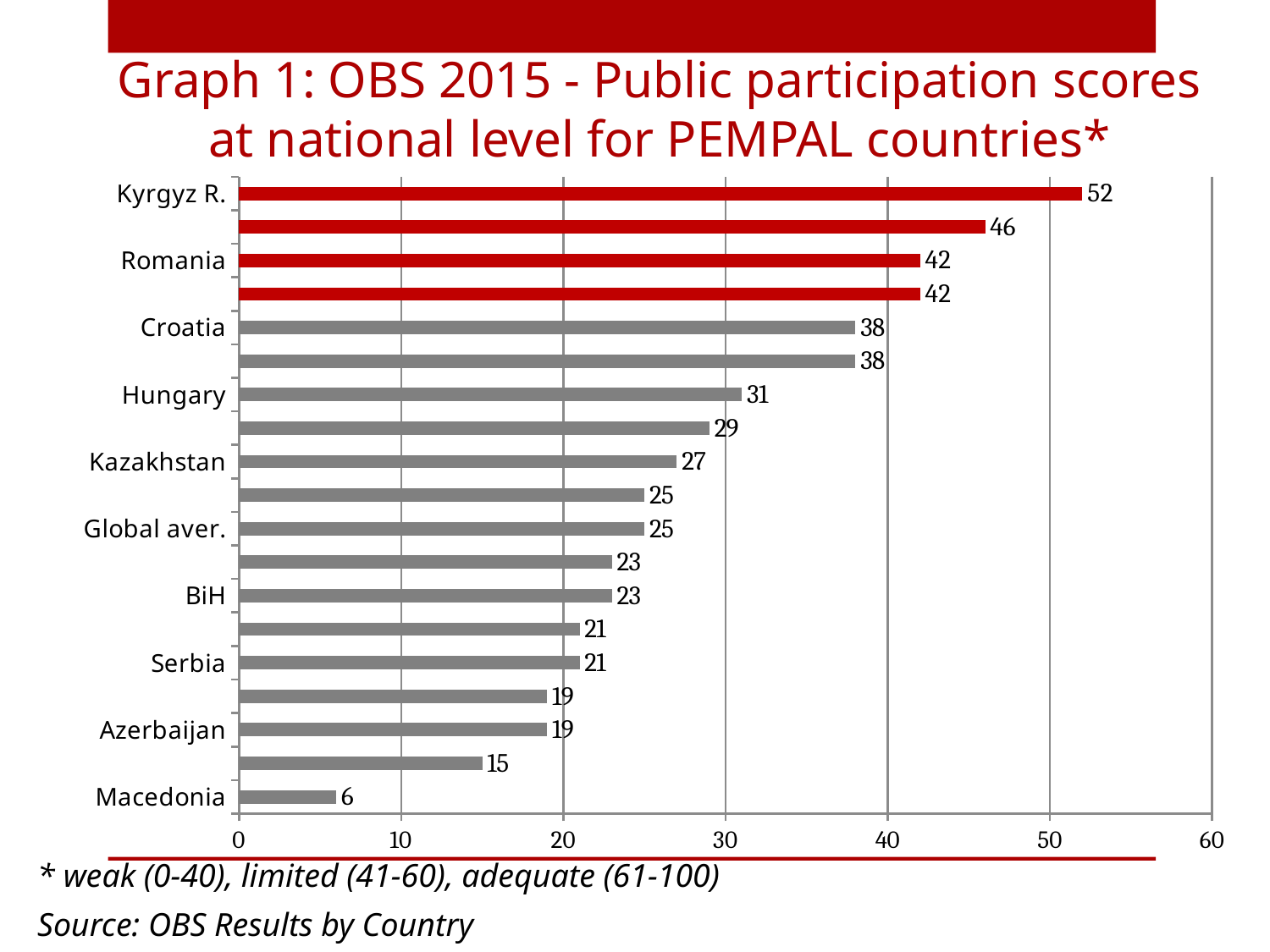
What is the value shown for Global aver.? 25 Which labelled country has the highest public participation score? Kyrgyz R. What is the difference between the scores of Kyrgyz R. and Romania? 10 Which labelled country has the lowest public participation score? Macedonia Which has a higher score, Croatia or Hungary? Croatia How many bars are plotted in the chart? 19 What is the public participation score for Romania? 42 What is the public participation score for Macedonia? 6 What is the title of the chart? Graph 1: OBS 2015 - Public participation scores at national level for PEMPAL countries* What is the public participation score for Kyrgyz R.? 52 Is the value for Kazakhstan greater or less than 30? less What type of chart is shown on the slide? Bar chart